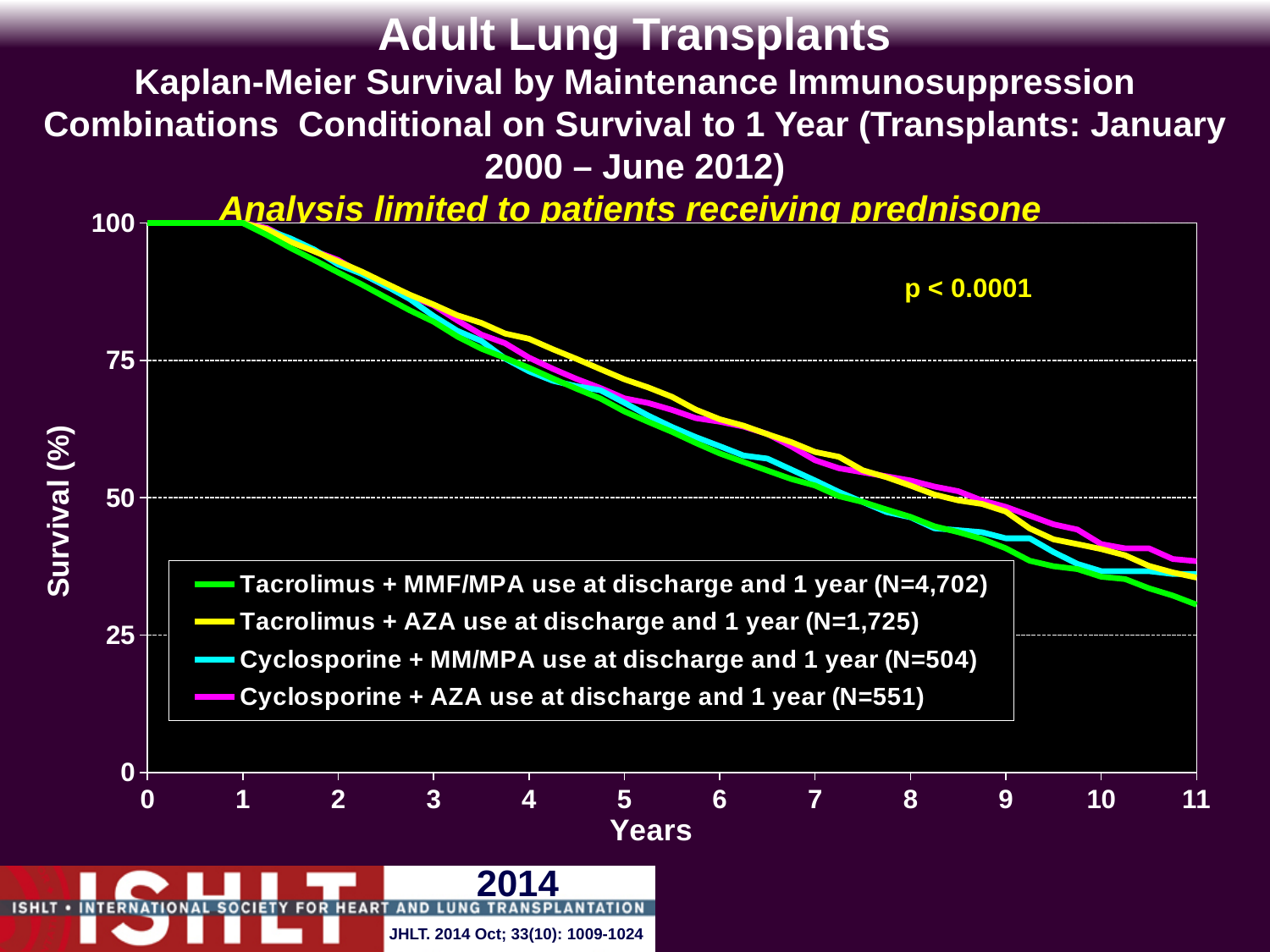
How many series does the legend list? 4 Which group has the lowest survival at year 11? Tacrolimus + MMF/MPA use at discharge and 1 year What is the survival (%) for all groups at year 0? 100 Do the survival curves rise or fall as years increase? fall What is the N for the Tacrolimus + MMF/MPA group in the legend? 4,702 What p-value is shown on the chart? p < 0.0001 Is the survival for Tacrolimus + MMF/MPA at year 11 greater or less than 25? greater At year 5, which has higher survival: Tacrolimus + AZA or Tacrolimus + MMF/MPA? Tacrolimus + AZA Is the survival for Tacrolimus + AZA at year 4 greater or less than 75? greater Is the survival for Tacrolimus + MMF/MPA at year 5 greater or less than 50? greater What kind of chart is shown on the slide? line chart